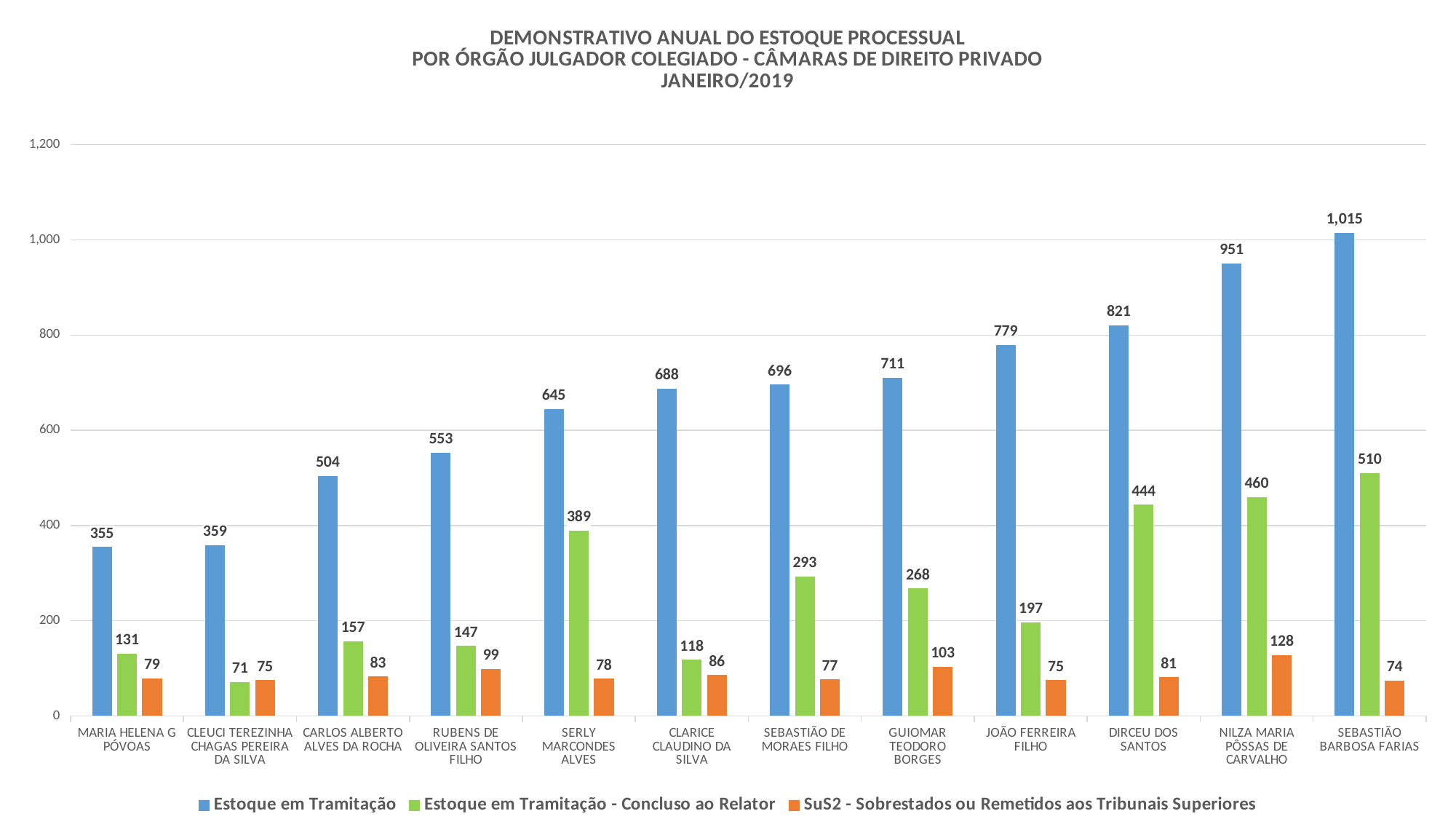
Which category has the highest value for "Estoque em Tramitação"? SEBASTIÃO BARBOSA FARIAS What is the difference between the "Estoque em Tramitação" values for DIRCEU DOS SANTOS and JOÃO FERREIRA FILHO? 42 Is the "Estoque em Tramitação" value for RUBENS DE OLIVEIRA SANTOS FILHO greater or less than 600? less What is the value of "SuS2 - Sobrestados ou Remetidos aos Tribunais Superiores" for NILZA MARIA PÔSSAS DE CARVALHO? 128 Which is larger: the "SuS2" value for GUIOMAR TEODORO BORGES or for CLARICE CLAUDINO DA SILVA? GUIOMAR TEODORO BORGES How many series does the legend list? 3 What kind of chart is shown on the slide? Bar chart What is the value of "Estoque em Tramitação - Concluso ao Relator" for SERLY MARCONDES ALVES? 389 Which category has the lowest value for "Estoque em Tramitação - Concluso ao Relator"? CLEUCI TEREZINHA CHAGAS PEREIRA DA SILVA What is the value of "Estoque em Tramitação" for SEBASTIÃO BARBOSA FARIAS? 1,015 How many categories (judges) are shown on the x axis? 12 Do the "Estoque em Tramitação" values generally rise or fall from left to right along the x axis? Rise